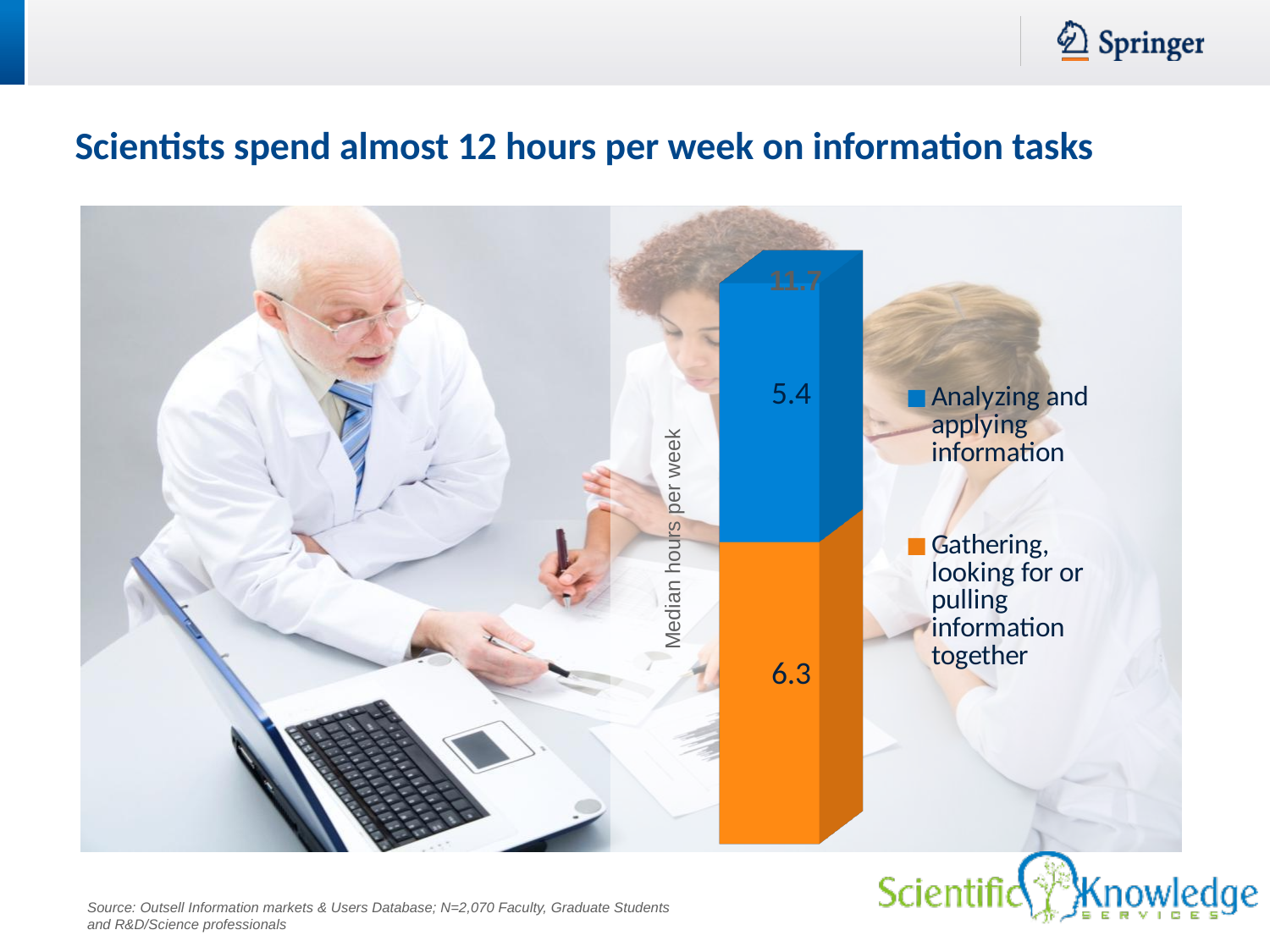
What is the total of the stacked bar? 11.7 What is the label on the vertical axis of the chart? Median hours per week What colour represents "Gathering, looking for or pulling information together" in the chart? Orange What is the difference between the "Gathering, looking for or pulling information together" value and the "Analyzing and applying information" value? 0.9 Which series has the lowest value in the chart? Analyzing and applying information How many bars are plotted in the chart? 1 What is the value for "Gathering, looking for or pulling information together" in the stacked bar? 6.3 Which segment of the stacked bar is larger: "Analyzing and applying information" or "Gathering, looking for or pulling information together"? Gathering, looking for or pulling information together Which series has the highest value in the chart? Gathering, looking for or pulling information together What kind of chart is shown on the slide? Stacked bar chart How many series does the legend list? 2 What is the value for "Analyzing and applying information" in the stacked bar? 5.4